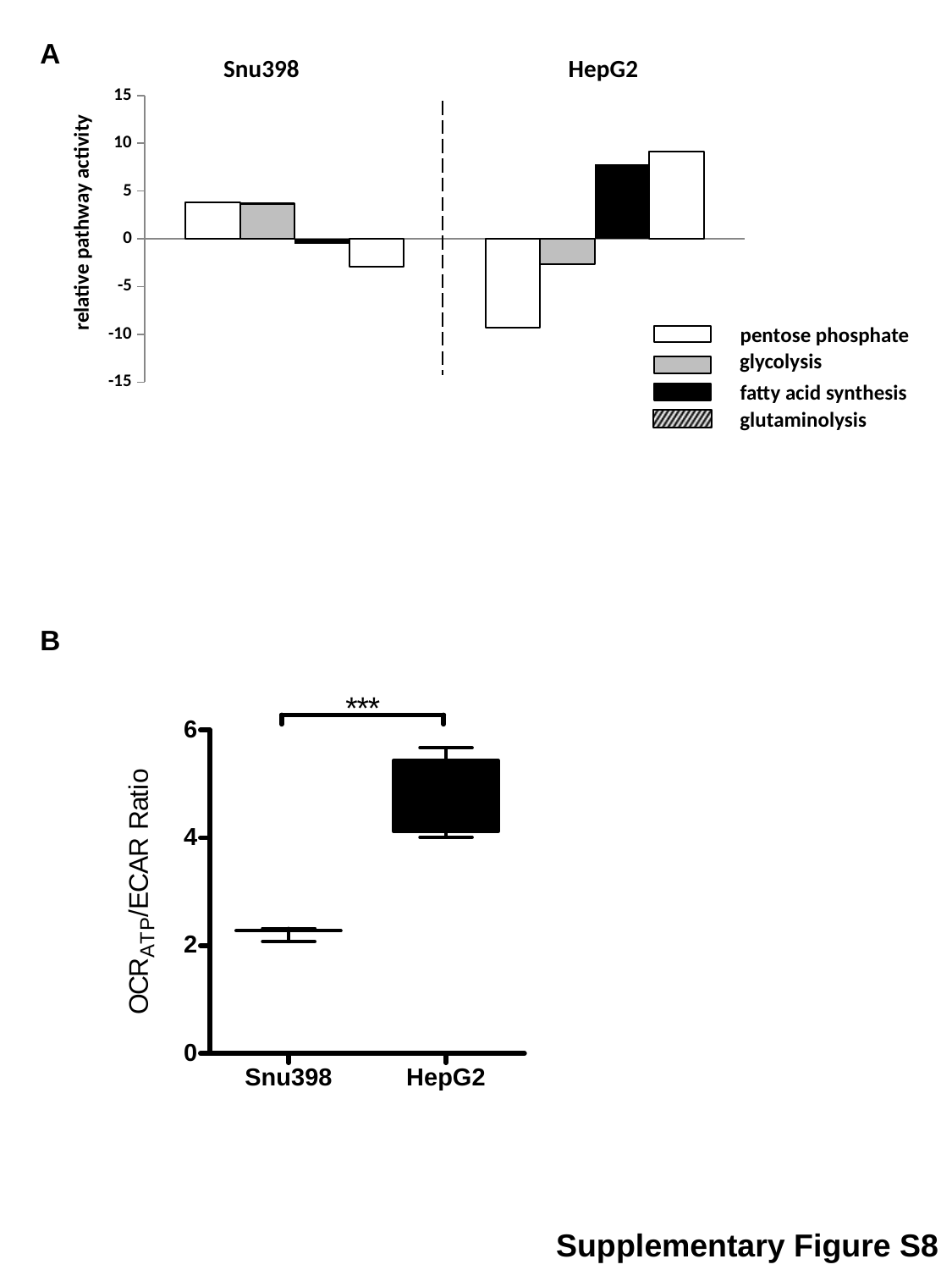
In chart A, is the glycolysis value for HepG2 greater or less than 0? less In chart B (OCR_ATP/ECAR Ratio), which cell line has the higher ratio, Snu398 or HepG2? HepG2 In chart A, which legend entry is shown with a black fill? fatty acid synthesis In chart A, is the fatty acid synthesis value for HepG2 greater or less than 5? greater In chart B (OCR_ATP/ECAR Ratio), how many cell lines are plotted on the x axis? 2 In chart A (relative pathway activity), what kind of chart is shown? bar chart In chart A, which cell line has the larger pentose phosphate value, Snu398 or HepG2? Snu398 In chart A, is the pentose phosphate value for Snu398 greater or less than 0? greater In chart A (relative pathway activity), how many series does the legend list? 4 In chart A, which cell line has the larger fatty acid synthesis value, Snu398 or HepG2? HepG2